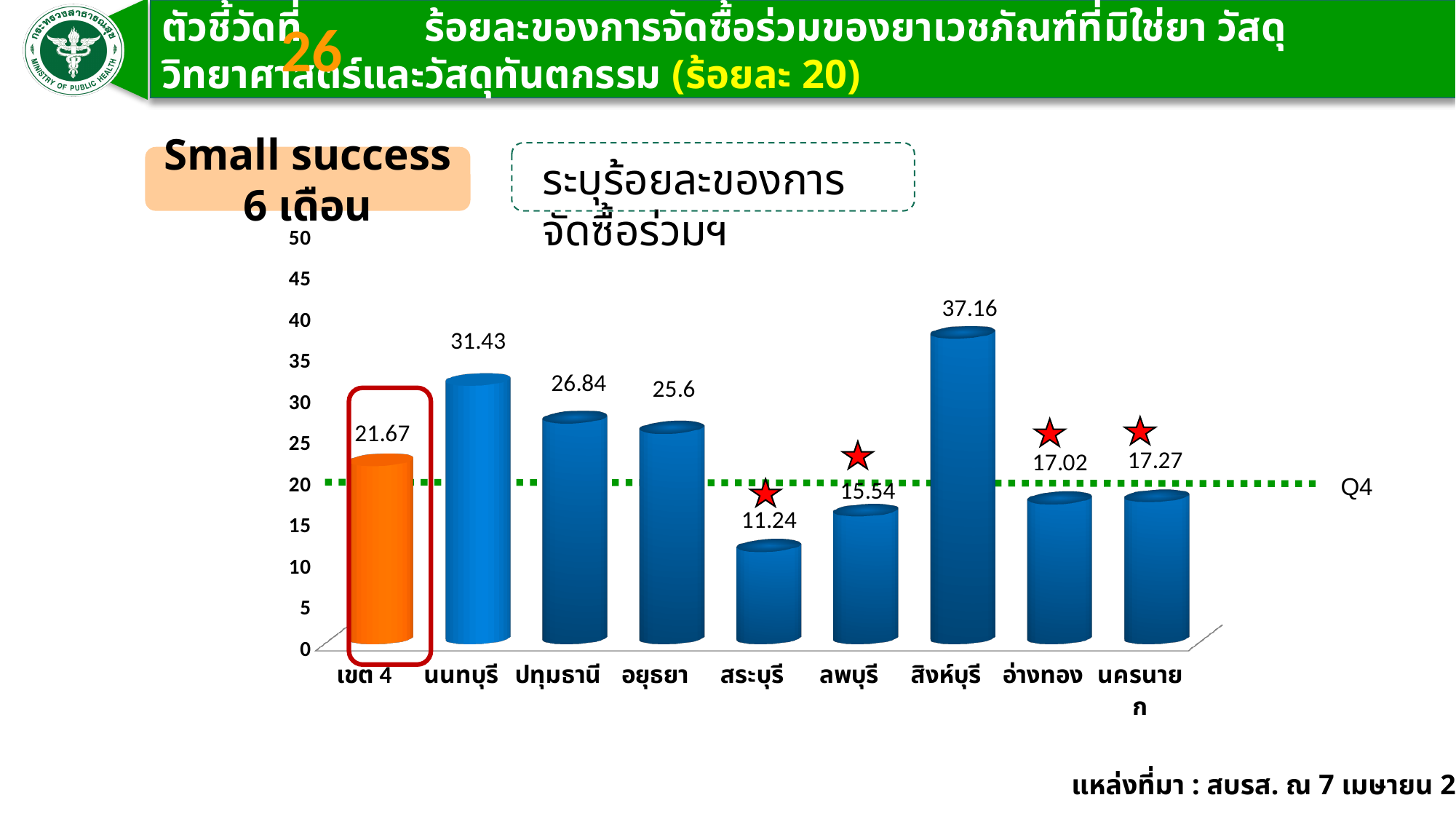
How many categories are shown on the x axis? 9 What is the value for สระบุรี? 11.24 What is the value for สิงห์บุรี? 37.16 What is the difference between the values for นนทบุรี and ปทุมธานี? 4.59 What is the value for เขต 4? 21.67 What is the value for อยุธยา? 25.6 Is the value for นครนายก greater or less than 20? less Which is larger, the value for อ่างทอง or the value for ลพบุรี? อ่างทอง Which category has the highest value? สิงห์บุรี What label is shown at the right end of the green dotted horizontal line? Q4 What type of chart is shown on the slide? bar chart Which category has the lowest value? สระบุรี